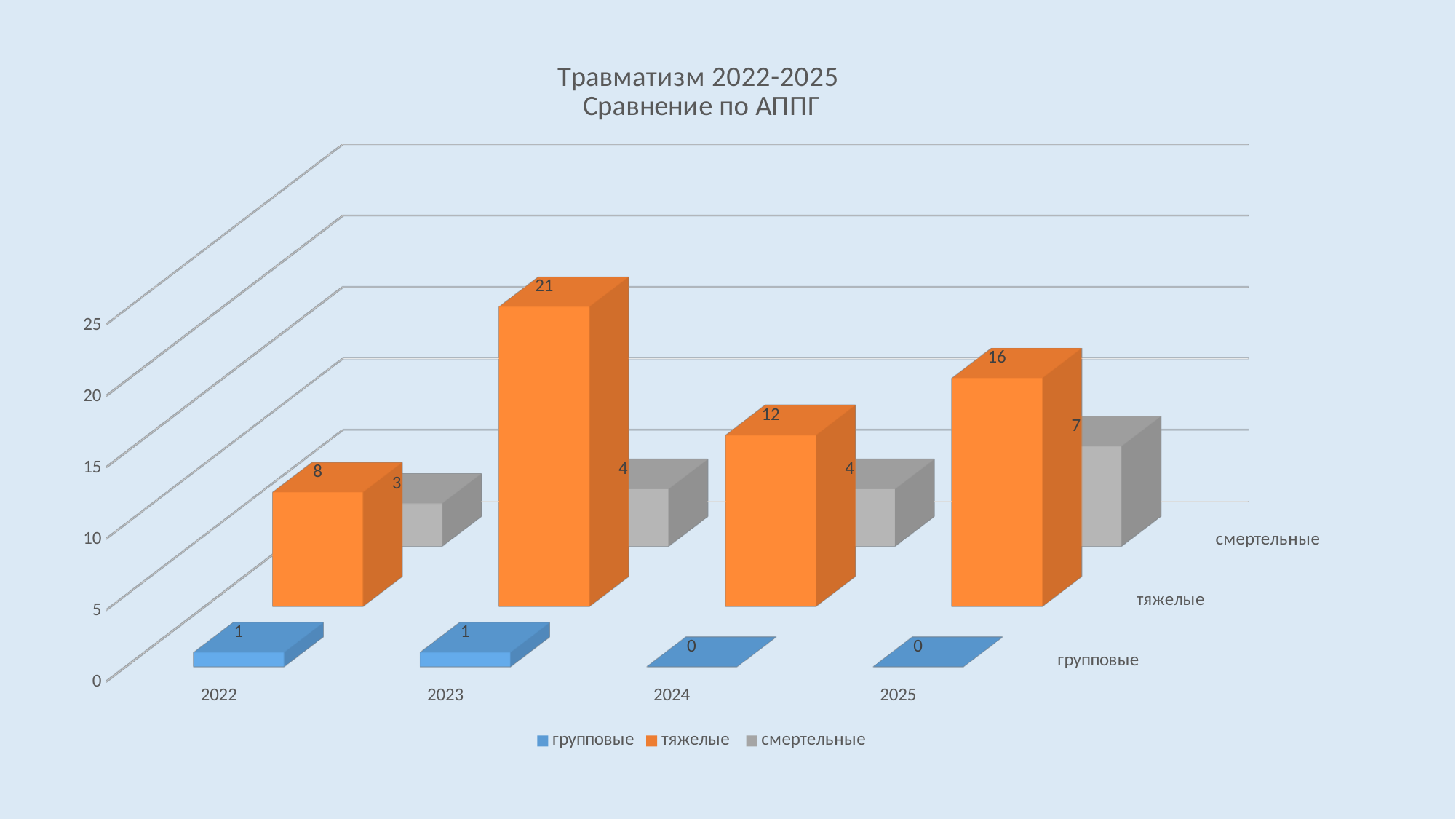
What is the title of the chart? Травматизм 2022-2025 Сравнение по АППГ What is the value for смертельные in 2025? 7 What is the value for тяжелые in 2023? 21 In which year is the value for тяжелые the lowest? 2022 How many series does the legend list? 3 What type of chart is shown on the slide? bar chart What is the difference between the тяжелые values for 2023 and 2024? 9 In which year is the value for тяжелые the highest? 2023 What is the value for групповые in 2024? 0 How many years are shown on the x axis? 4 Does the value for смертельные rise or fall from 2022 to 2025? rise Which is larger: the смертельные value for 2025 or for 2022? 2025